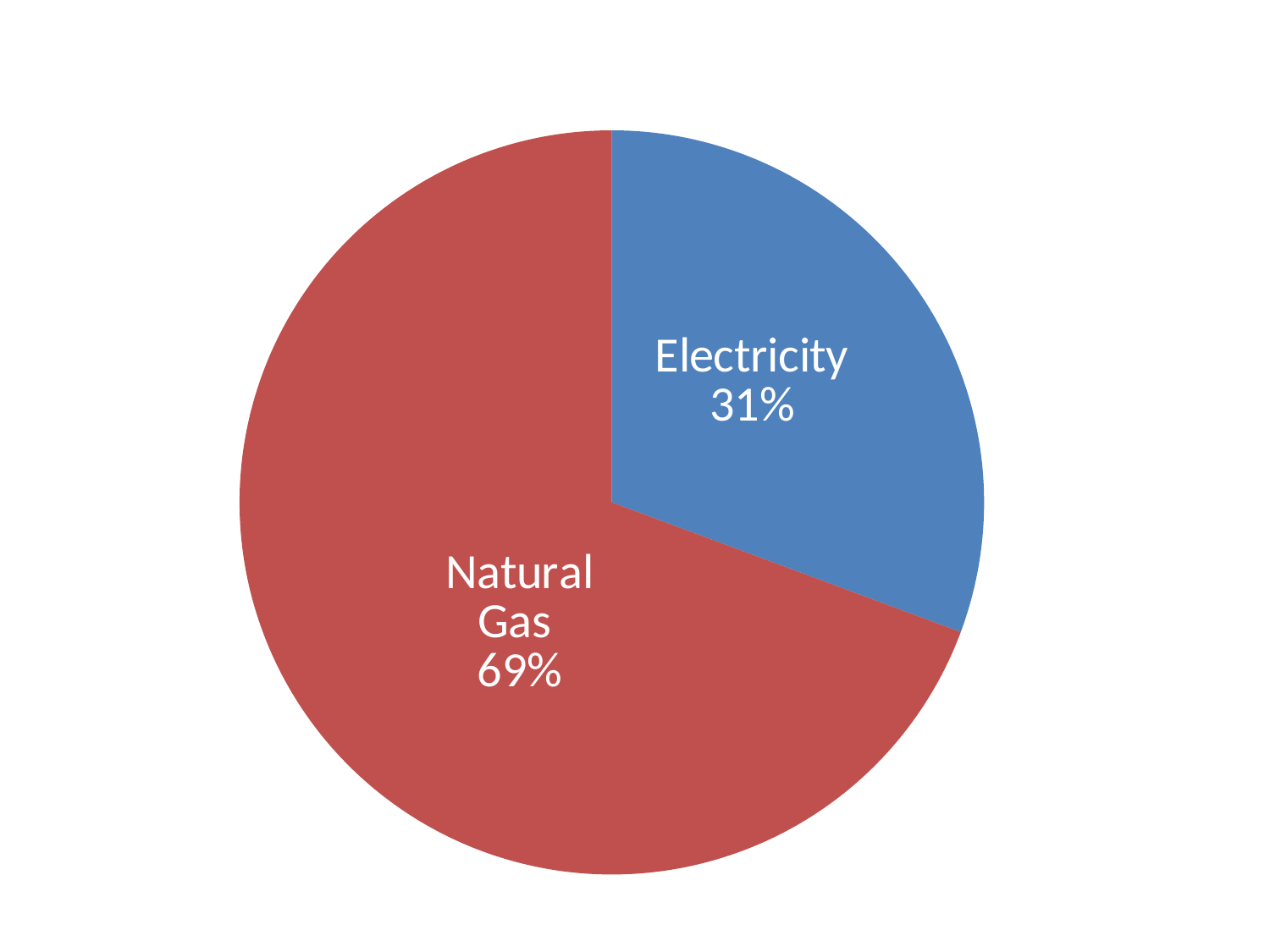
What share of the pie does Electricity represent? 31% What kind of chart is shown on the slide? Pie chart What is the difference in percentage points between the Natural Gas and Electricity slices? 38 How many slices does the pie chart have? 2 What colour is the Electricity slice? Blue Which slice of the pie is the smallest? Electricity Is the share for Natural Gas greater or less than 50%? greater Which slice of the pie is the largest? Natural Gas Which is larger, the Electricity slice or the Natural Gas slice? Natural Gas What colour is the Natural Gas slice? Red What share of the pie does Natural Gas represent? 69%